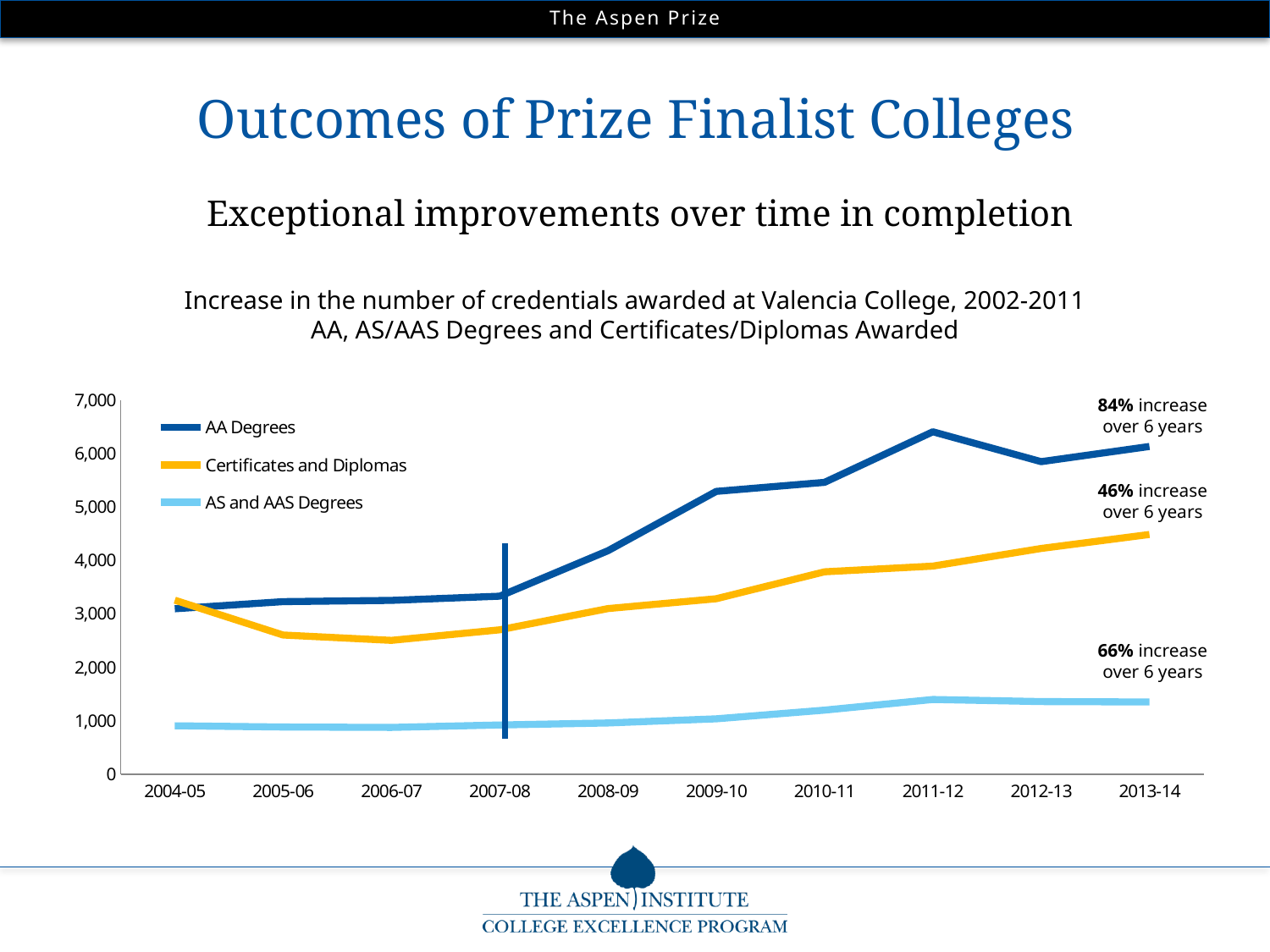
According to the annotation, what percentage increase over 6 years is shown for the AS and AAS Degrees line? 66% Which series has the lowest value in 2013-14? AS and AAS Degrees How many academic years are shown along the x axis? 10 In 2004-05, which is larger: AA Degrees or Certificates and Diplomas? Certificates and Diplomas Is the value for AA Degrees in 2011-12 greater or less than 6,000? greater What kind of chart is shown on the slide? line chart Does the AA Degrees line generally rise or fall from 2004-05 to 2013-14? rise Which series has the highest value in 2013-14? AA Degrees Is the value for Certificates and Diplomas in 2006-07 greater or less than 3,000? less How many series does the legend list? 3 According to the annotation, what percentage increase over 6 years is shown for the AA Degrees line? 84%